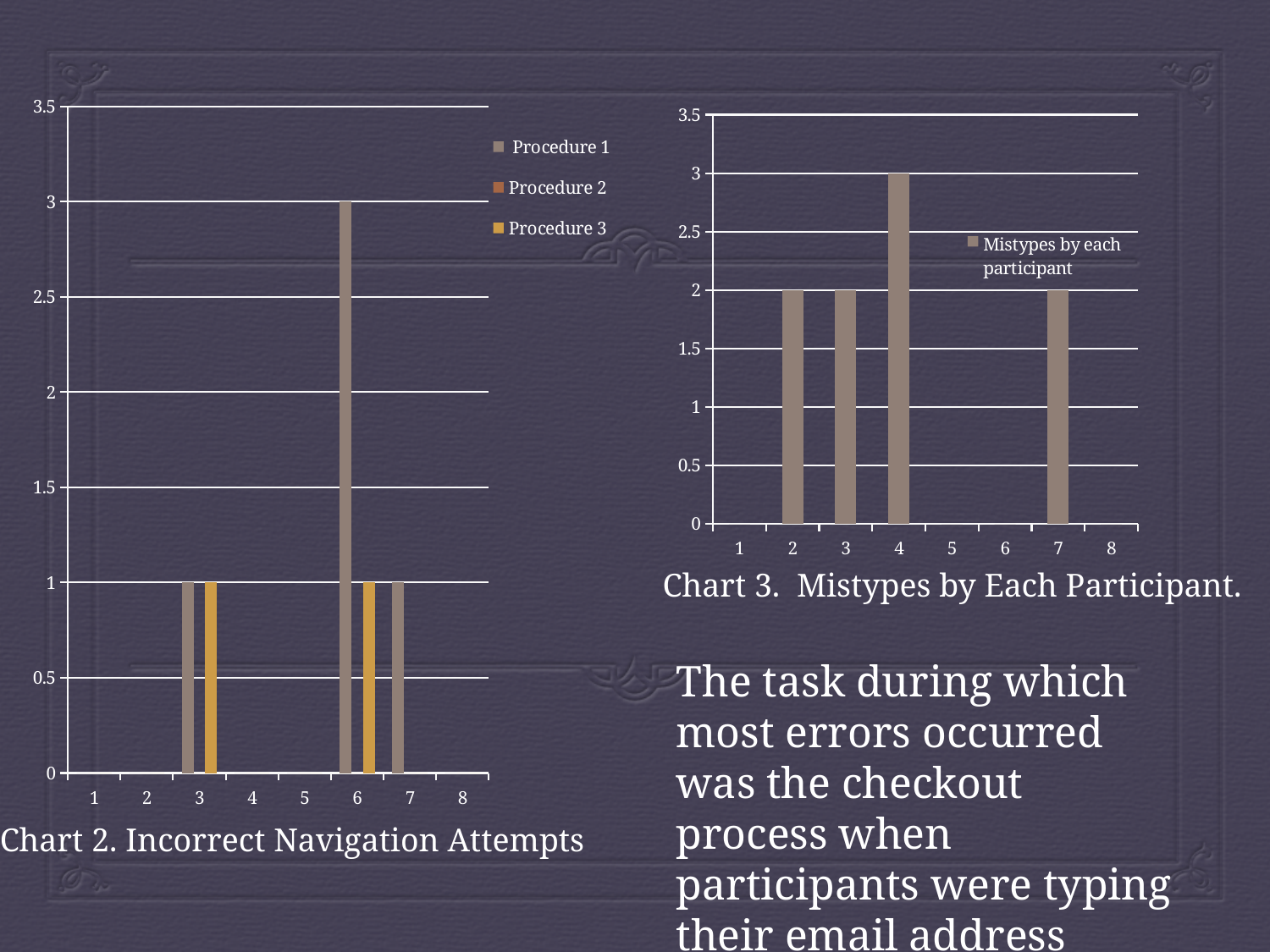
In Chart 3 (Mistypes by Each Participant), what is the value for participant 4? 3 In Chart 3 (Mistypes by Each Participant), how many participants are shown on the x axis? 8 What is the title of the chart on the right side of the slide? Chart 3. Mistypes by Each Participant. In Chart 3 (Mistypes by Each Participant), what is the value for participant 7? 2 In Chart 3 (Mistypes by Each Participant), which participant has the highest number of mistypes? 4 In Chart 2 (Incorrect Navigation Attempts), what is the Procedure 1 value for participant 6? 3 In Chart 2 (Incorrect Navigation Attempts), which participant has the highest Procedure 1 value? 6 In Chart 3 (Mistypes by Each Participant), is the value for participant 4 greater or less than 2.5? greater What kind of chart is Chart 2 (Incorrect Navigation Attempts)? Bar chart In Chart 3 (Mistypes by Each Participant), what is the difference between the values for participant 4 and participant 2? 1 In Chart 2 (Incorrect Navigation Attempts), which is larger for participant 6: the Procedure 1 value or the Procedure 3 value? Procedure 1 In Chart 2 (Incorrect Navigation Attempts), how many series does the legend list? 3